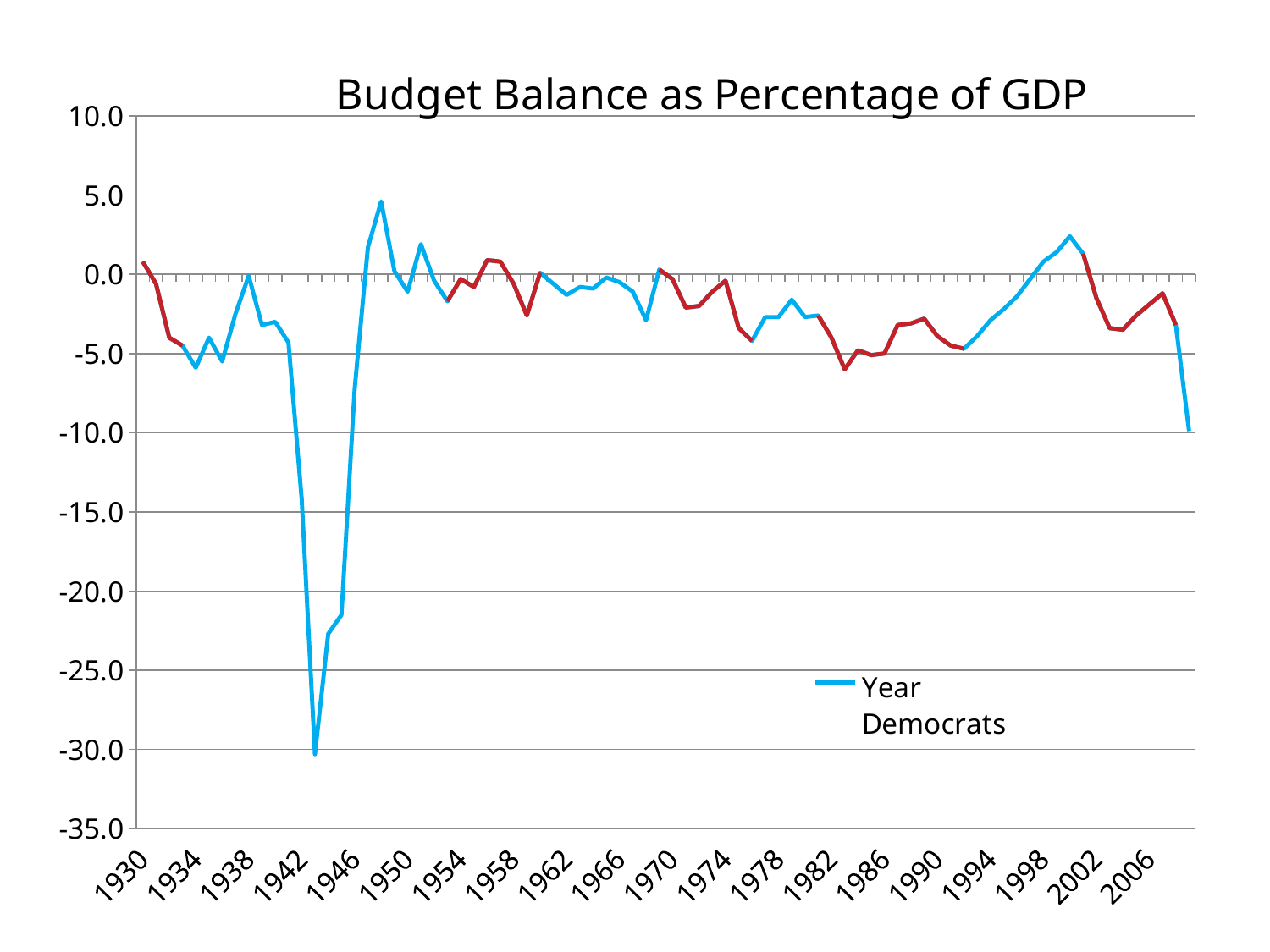
Around which year does the budget balance reach its lowest point? 1943 What is the legend entry shown for the blue line? Year Democrats Which is larger, the value for 1948 or the value for 2000? 1948 What is the title of the chart? Budget Balance as Percentage of GDP Around which year does the budget balance reach its highest point? 1948 What kind of chart is shown on the slide? line chart How many series does the legend list? 1 Is the value for 1948 greater or less than 0.0? greater Is the value for 2009 greater or less than -5.0? less Do the values rise or fall from 1940 to 1943? fall Is the value for 2000 greater or less than 0.0? greater